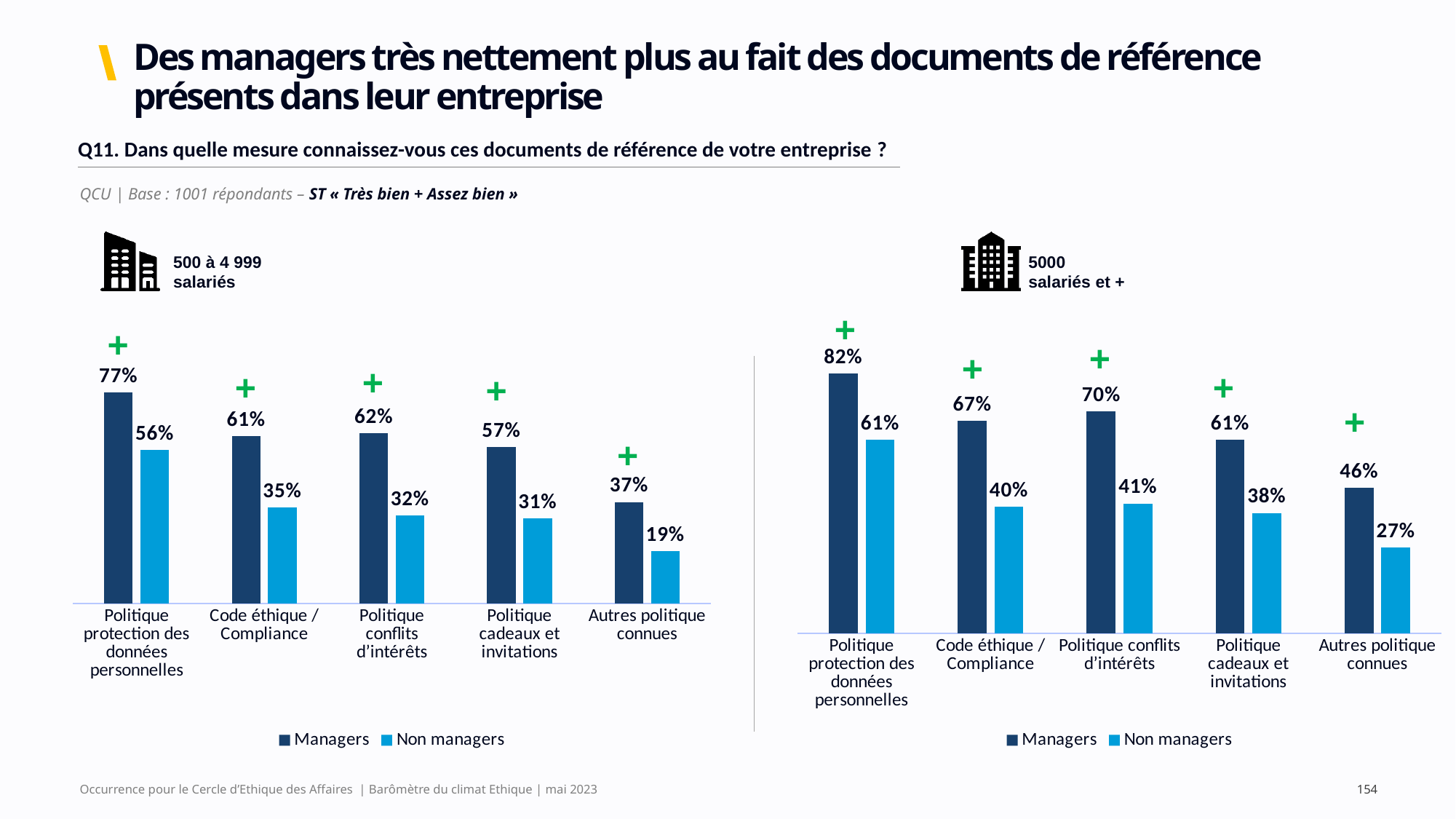
In the left chart (500 à 4 999 salariés), which category has the lowest Non managers value? Autres politique connues In the right chart (5000 salariés et +), what is the value for Non managers for Code éthique / Compliance? 40% In the left chart (500 à 4 999 salariés), what is the difference between the Managers and Non managers values for Code éthique / Compliance? 26 percentage points How many series does the legend of the right chart (5000 salariés et +) list? 2 What type of chart is used on this slide? Bar chart In the right chart (5000 salariés et +), which is larger: the Managers value for Politique cadeaux et invitations or the Non managers value for Politique protection des données personnelles? They are equal (61%) In the right chart (5000 salariés et +), which category has the highest Managers value? Politique protection des données personnelles In the left chart (500 à 4 999 salariés), what is the value for Non managers for Autres politique connues? 19% In the right chart (5000 salariés et +), what is the difference between the Managers and Non managers values for Politique conflits d'intérêts? 29 percentage points In the left chart (500 à 4 999 salariés), what is the value for Managers for Politique protection des données personnelles? 77% In the left chart (500 à 4 999 salariés), which is larger: the Non managers value for Politique conflits d'intérêts or the Non managers value for Politique cadeaux et invitations? Politique conflits d'intérêts (32%) How many categories are shown in the left chart (500 à 4 999 salariés)? 5